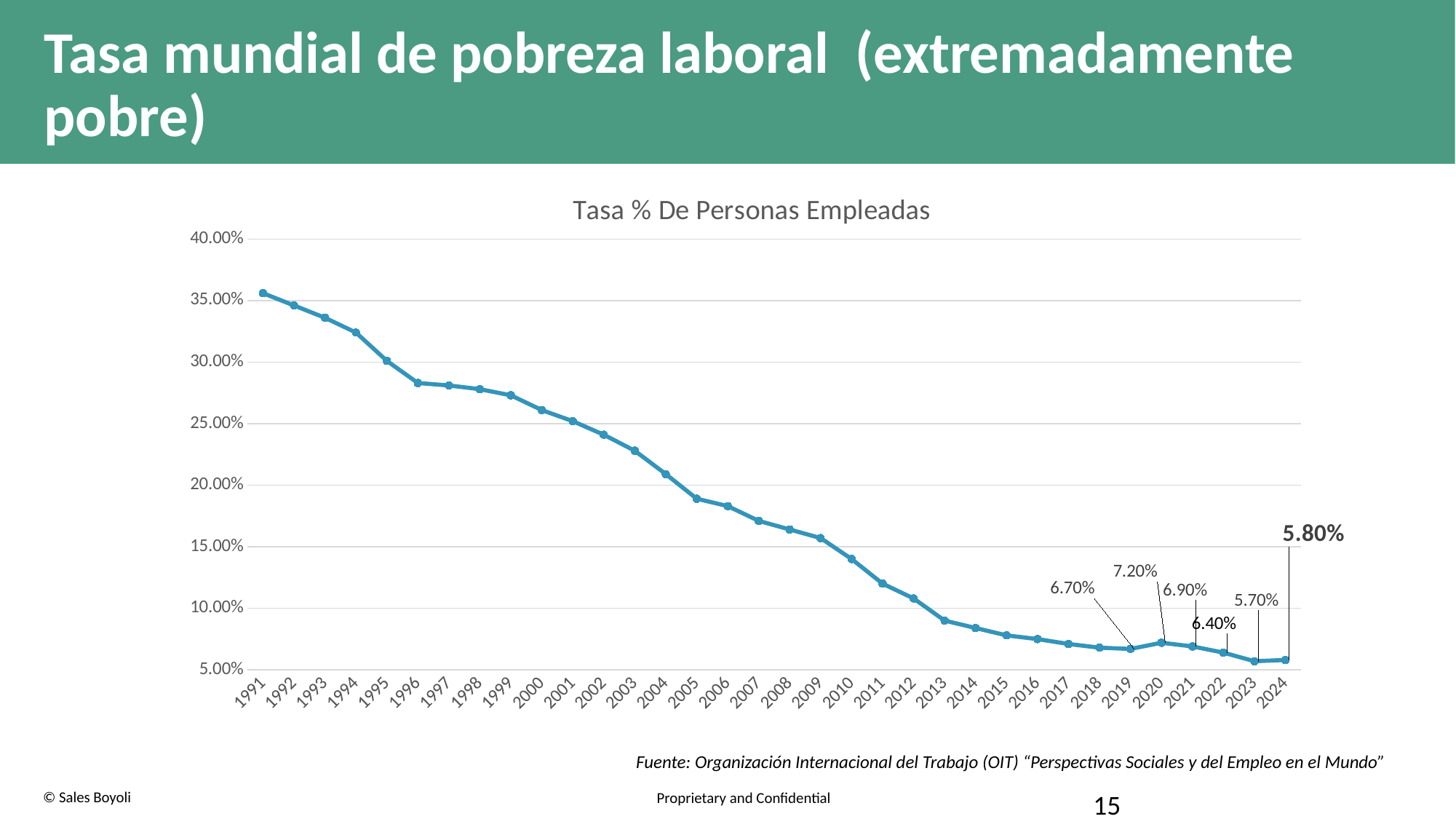
Do the values generally rise or fall from 1991 to 2024? fall What is the chart's title? Tasa % De Personas Empleadas Which is larger, the value for 2021 or the value for 2019? 2021 What is the value for 2022? 6.40% What is the value for 2019? 6.70% What kind of chart is shown on the slide? line chart Is the value for 2005 greater or less than 20.00%? less What is the value for 2024? 5.80% What is the difference between the values for 2020 and 2023? 1.50% Which year has the highest value on the chart? 1991 What is the value for 2020? 7.20% Which year has the lowest value on the chart? 2023